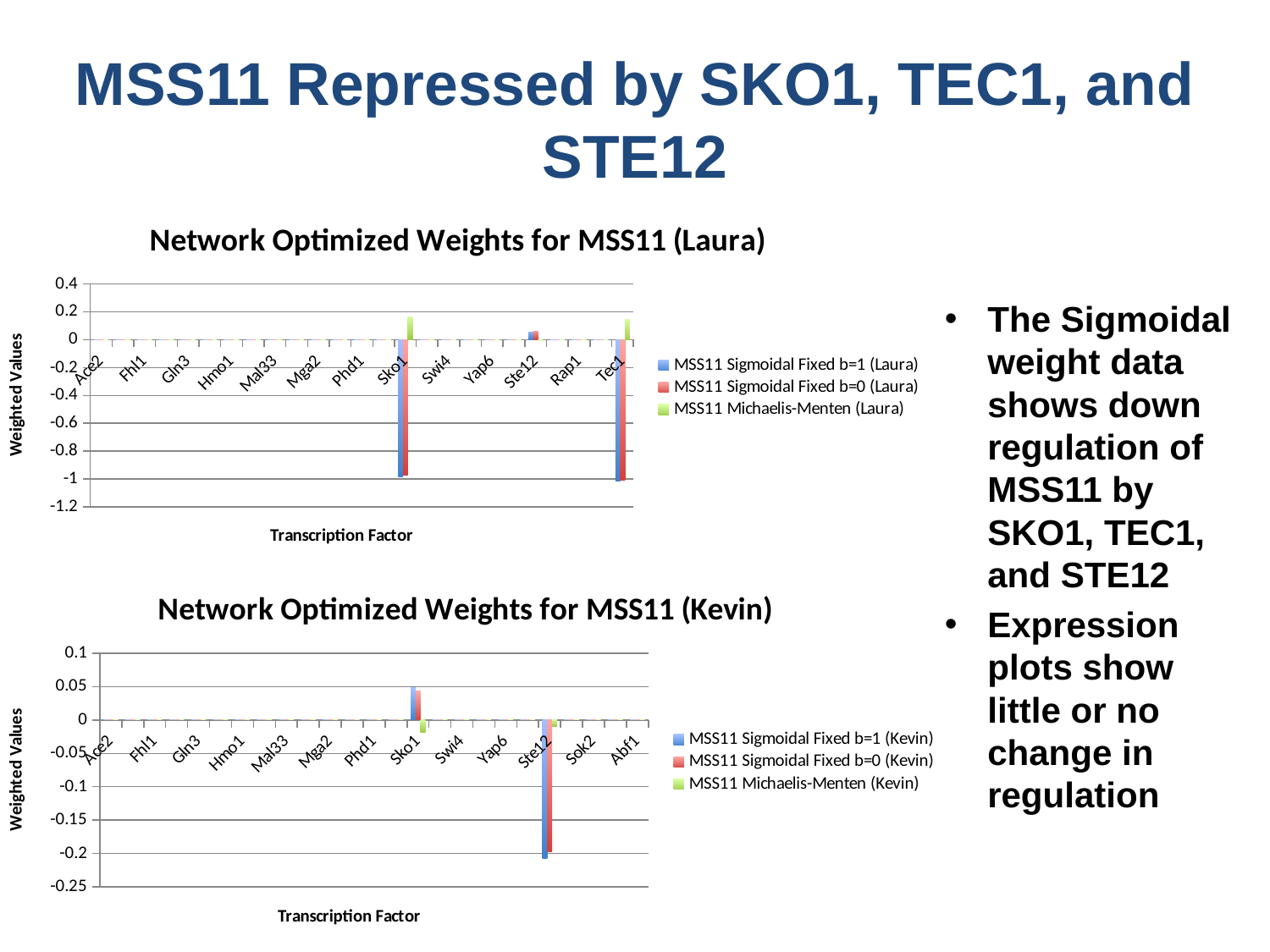
In "Network Optimized Weights for MSS11 (Laura)", is the value for Sko1 in the MSS11 Sigmoidal Fixed b=1 (Laura) series greater or less than -0.8? less In "Network Optimized Weights for MSS11 (Kevin)", is the value for Sko1 in the MSS11 Sigmoidal Fixed b=1 (Kevin) series greater or less than 0? greater What is the x-axis title of "Network Optimized Weights for MSS11 (Laura)"? Transcription Factor In "Network Optimized Weights for MSS11 (Kevin)", is the value for Ste12 in the MSS11 Sigmoidal Fixed b=1 (Kevin) series greater or less than -0.15? less In "Network Optimized Weights for MSS11 (Laura)", which is larger in the MSS11 Sigmoidal Fixed b=1 (Laura) series, the value for Ste12 or the value for Sko1? Ste12 What is the y-axis title of "Network Optimized Weights for MSS11 (Kevin)"? Weighted Values In "Network Optimized Weights for MSS11 (Kevin)", which transcription factor has the lowest value in the MSS11 Sigmoidal Fixed b=1 (Kevin) series? Ste12 How many series does the legend of "Network Optimized Weights for MSS11 (Kevin)" list? 3 In "Network Optimized Weights for MSS11 (Kevin)", which is larger in the MSS11 Sigmoidal Fixed b=0 (Kevin) series, the value for Sko1 or the value for Ste12? Sko1 What kind of chart is "Network Optimized Weights for MSS11 (Laura)"? bar chart